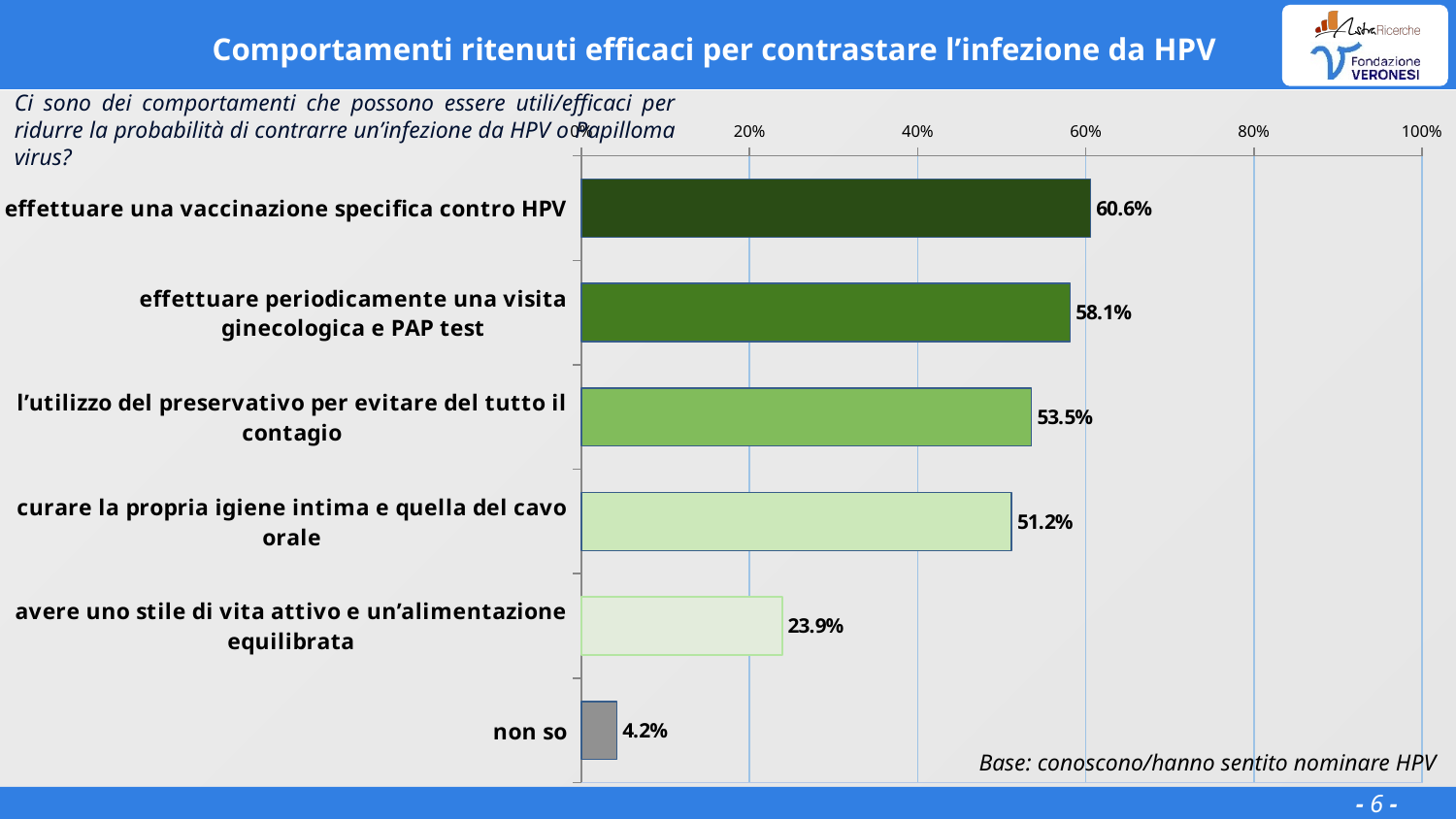
What is the difference between 'effettuare una vaccinazione specifica contro HPV' and 'effettuare periodicamente una visita ginecologica e PAP test'? 2.5% What is the title of the chart? Comportamenti ritenuti efficaci per contrastare l'infezione da HPV What type of chart is shown on the slide? bar chart What percentage of respondents consider 'effettuare una vaccinazione specifica contro HPV' effective? 60.6% What is the value for 'non so'? 4.2% Which behaviour has the highest percentage? effettuare una vaccinazione specifica contro HPV Which category has the lowest value? non so How many categories are shown in the chart? 6 Is the value for 'avere uno stile di vita attivo e un'alimentazione equilibrata' greater or less than 20%? greater What is the value shown for 'curare la propria igiene intima e quella del cavo orale'? 51.2% What is the difference between 'l'utilizzo del preservativo per evitare del tutto il contagio' and 'avere uno stile di vita attivo e un'alimentazione equilibrata'? 29.6% Which is larger: 'l'utilizzo del preservativo per evitare del tutto il contagio' or 'curare la propria igiene intima e quella del cavo orale'? l'utilizzo del preservativo per evitare del tutto il contagio